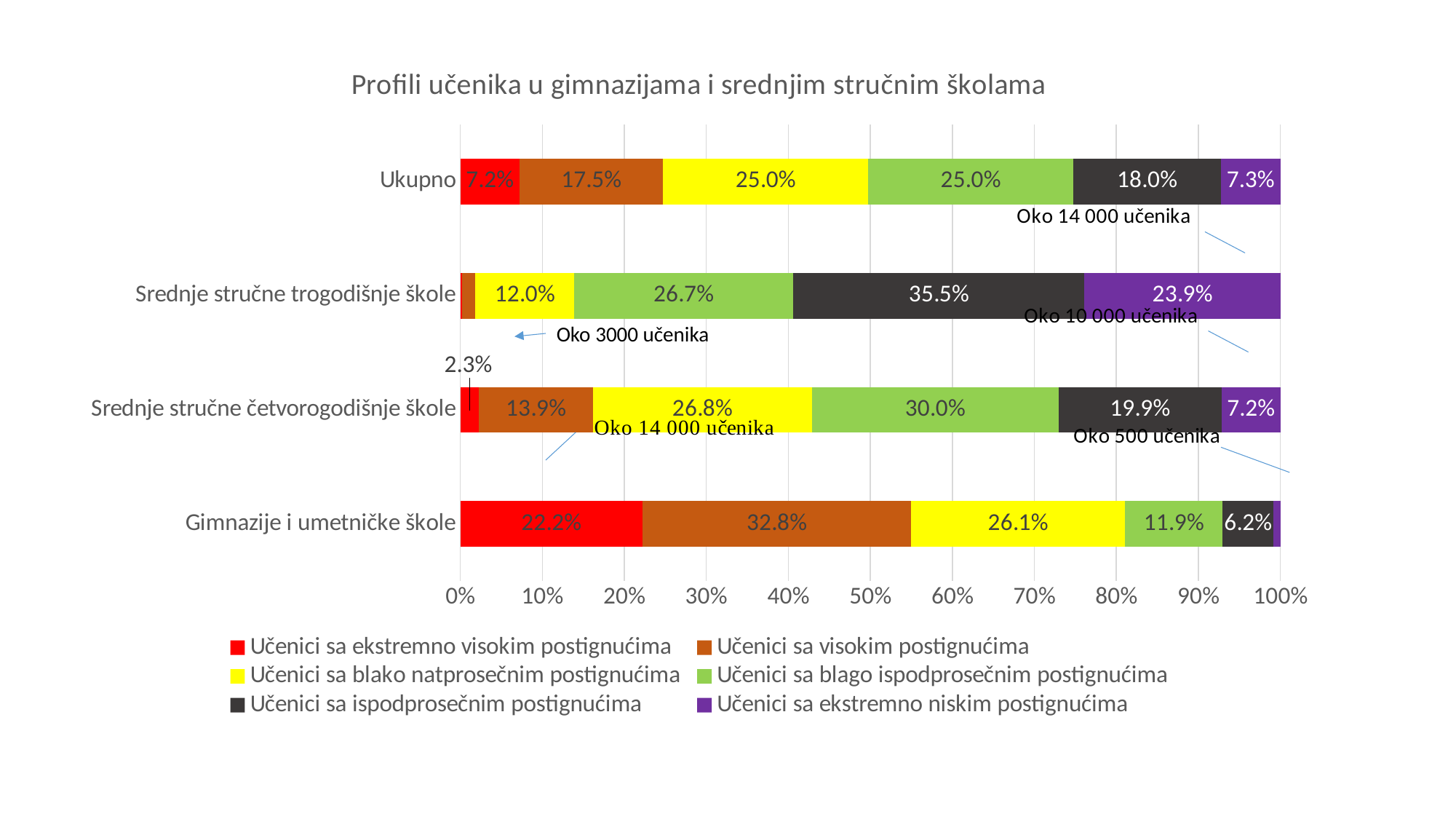
What is the value for 'Učenici sa ekstremno visokim postignućima' in the 'Gimnazije i umetničke škole' bar? 22.2% What is the value for 'Učenici sa ekstremno visokim postignućima' in the 'Srednje stručne četvorogodišnje škole' bar? 2.3% Which has a larger share of 'Učenici sa blago ispodprosečnim postignućima': 'Srednje stručne četvorogodišnje škole' or 'Ukupno'? Srednje stručne četvorogodišnje škole How many school categories are plotted on the chart? 4 Which category has the highest share of 'Učenici sa ekstremno visokim postignućima'? Gimnazije i umetničke škole What is the title of the chart? Profili učenika u gimnazijama i srednjim stručnim školama Which category has the highest share of 'Učenici sa ekstremno niskim postignućima'? Srednje stručne trogodišnje škole What kind of chart is shown on the slide? Stacked bar chart What is the value for 'Učenici sa visokim postignućima' in the 'Ukupno' bar? 17.5% What is the value for 'Učenici sa ispodprosečnim postignućima' in the 'Srednje stručne trogodišnje škole' bar? 35.5% How many series does the legend list? 6 What is the difference between the 'Učenici sa visokim postignućima' share for 'Gimnazije i umetničke škole' and for 'Ukupno'? 15.3 percentage points